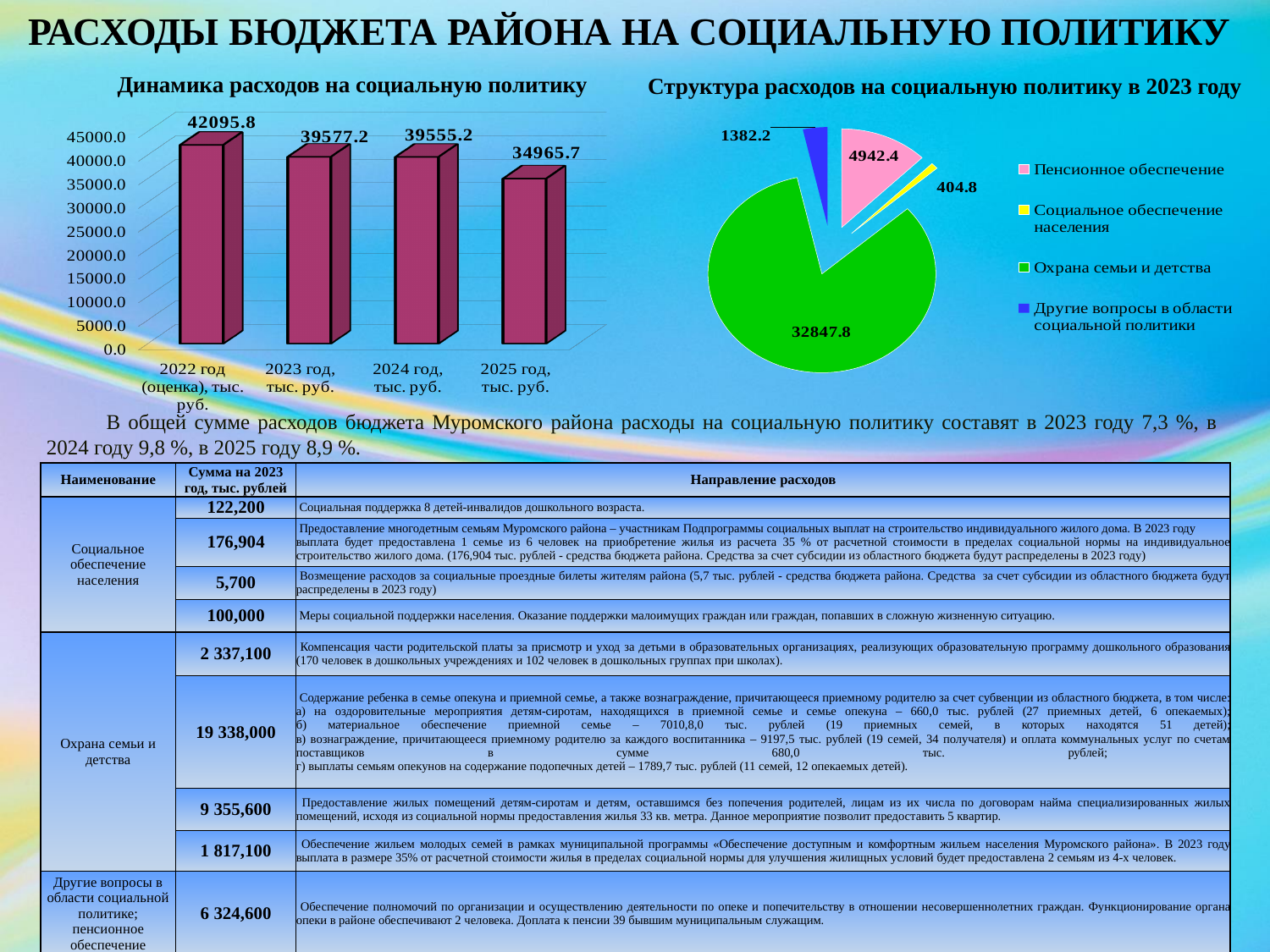
On the bar chart 'Динамика расходов на социальную политику', what is the value for 2022 год (оценка)? 42095.8 What type of chart is 'Динамика расходов на социальную политику'? bar chart On the pie chart 'Структура расходов на социальную политику в 2023 году', how many categories does the legend list? 4 On the bar chart 'Динамика расходов на социальную политику', do the values rise or fall from 2022 to 2025? fall On the pie chart 'Структура расходов на социальную политику в 2023 году', which category is the largest? Охрана семьи и детства On the bar chart 'Динамика расходов на социальную политику', which year has the lowest value? 2025 год On the pie chart 'Структура расходов на социальную политику в 2023 году', what is the value for Охрана семьи и детства? 32847.8 On the pie chart 'Структура расходов на социальную политику в 2023 году', what is the value for Социальное обеспечение населения? 404.8 On the bar chart 'Динамика расходов на социальную политику', which year has the highest value? 2022 год (оценка) On the bar chart 'Динамика расходов на социальную политику', what is the difference between the 2022 and 2025 values? 7130.1 On the bar chart 'Динамика расходов на социальную политику', what is the value for 2025 год? 34965.7 On the bar chart 'Динамика расходов на социальную политику', how many bars are shown? 4